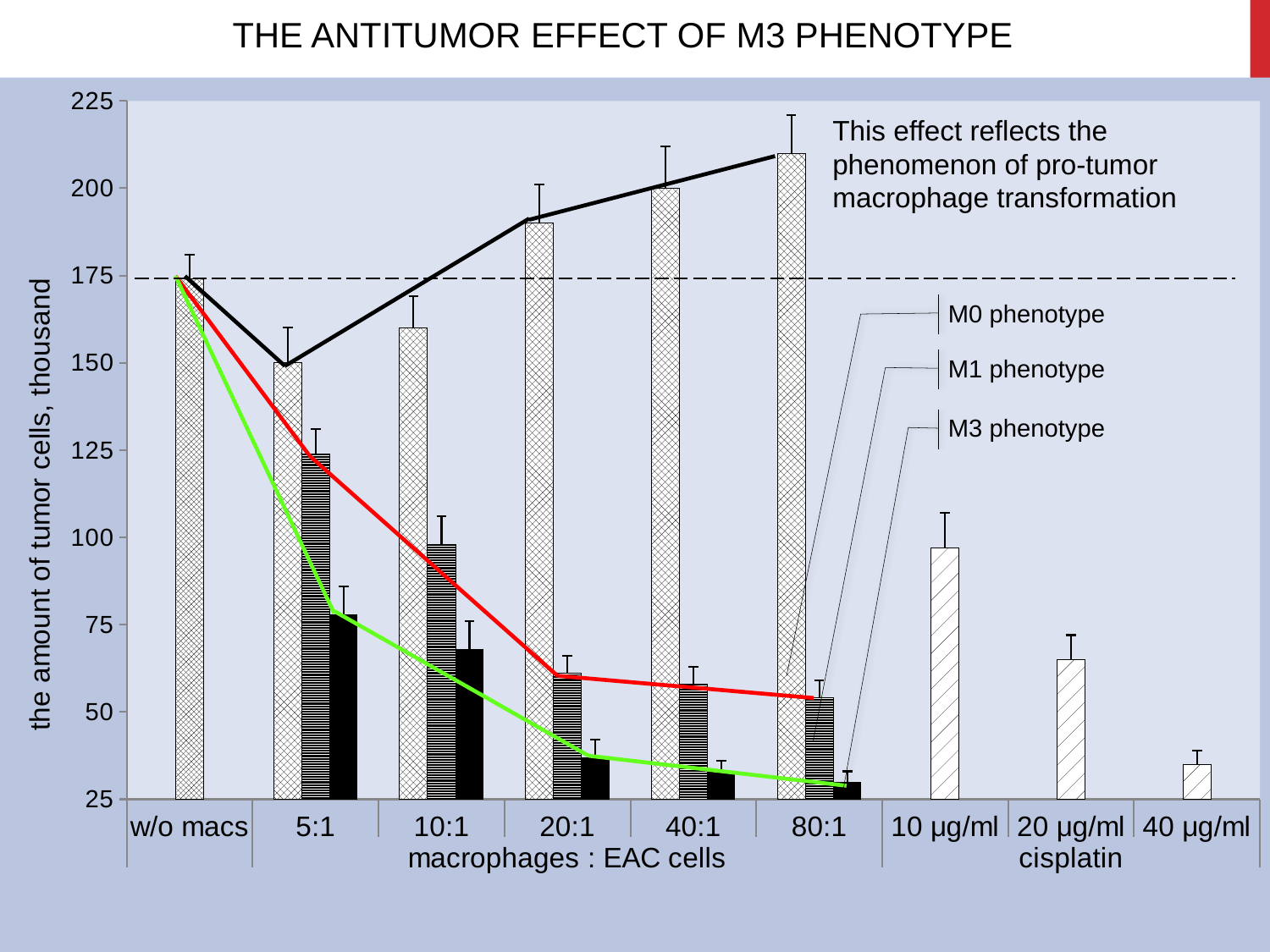
How many cisplatin concentrations are shown on the x axis? 3 Is the value for the M0 phenotype at the 80:1 ratio greater or less than 200? greater What kind of chart is shown on the slide? bar chart Which cisplatin concentration has the lowest amount of tumor cells? 40 µg/ml At the 20:1 ratio, which is larger: the M0 phenotype bar or the M3 phenotype bar? M0 phenotype Is the value for 40 µg/ml cisplatin greater or less than 50? less What is the label of the vertical axis? the amount of tumor cells, thousand Do the M3 phenotype bars rise or fall as the macrophage : EAC cells ratio increases from 5:1 to 80:1? fall Is the value for the M3 phenotype at the 5:1 ratio greater or less than 100? less What is the title of the chart? THE ANTITUMOR EFFECT OF M3 PHENOTYPE At which macrophage : EAC cells ratio is the M0 phenotype bar the highest? 80:1